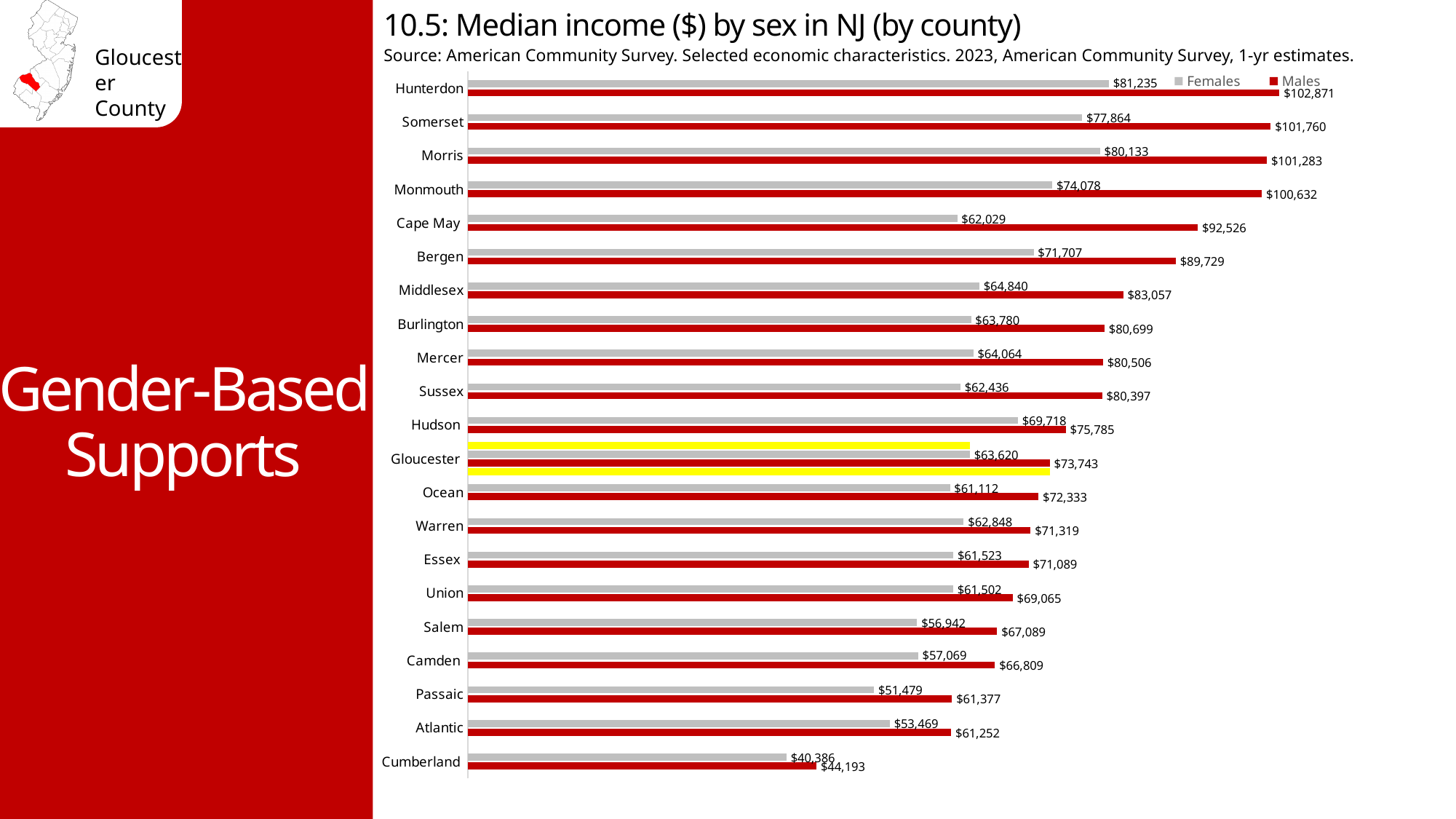
How many series does the legend list? 2 Which colour represents the Males series in the chart? Red Which is larger: the female median income in Bergen County or in Hudson County? Bergen County Which county has the lowest median income for females? Cumberland What is the difference between the male median incomes of Hunterdon and Cumberland counties? $58,678 What is the median income for females in Hunterdon County? $81,235 What kind of chart is shown on the slide? Bar chart How many counties are shown in the chart? 21 Which county has the highest median income for males? Hunterdon What is the difference between male and female median income in Gloucester County? $10,123 What is the median income for females in Cumberland County? $40,386 What is the median income for males in Gloucester County? $73,743